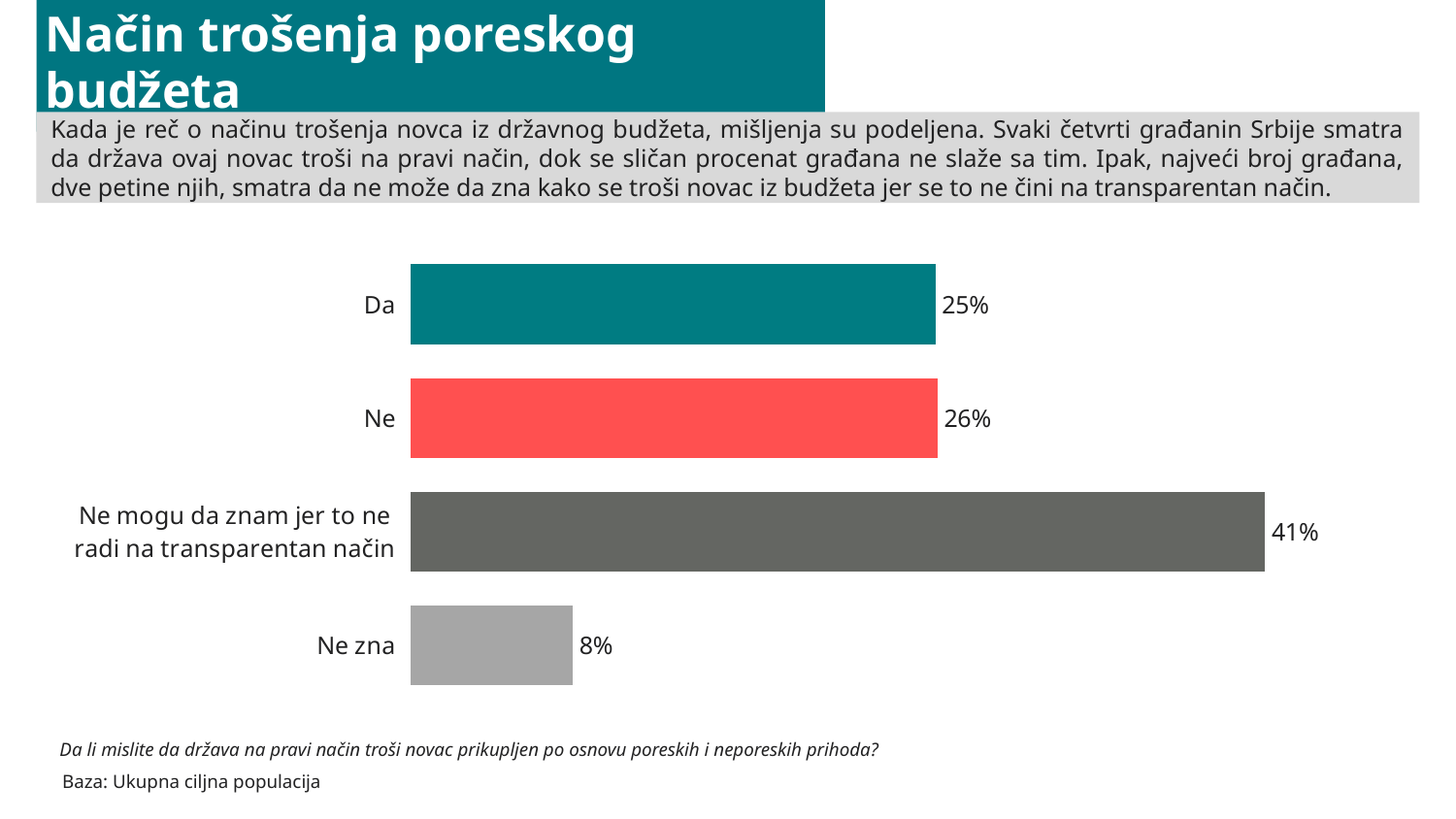
Which category has the lowest value? Ne zna Which is larger, the value for "Ne" or the value for "Ne zna"? Ne What is the value for "Ne zna"? 8% How many categories are shown in the chart? 4 Which category has the highest value? Ne mogu da znam jer to ne radi na transparentan način What is the difference between the values for "Ne mogu da znam jer to ne radi na transparentan način" and "Ne"? 15% What kind of chart is shown on the slide? Bar chart What colour is the bar for "Ne"? Red What is the value for "Ne mogu da znam jer to ne radi na transparentan način"? 41% What is the value for "Ne"? 26% What is the value for "Da"? 25% What is the difference between the values for "Da" and "Ne zna"? 17%